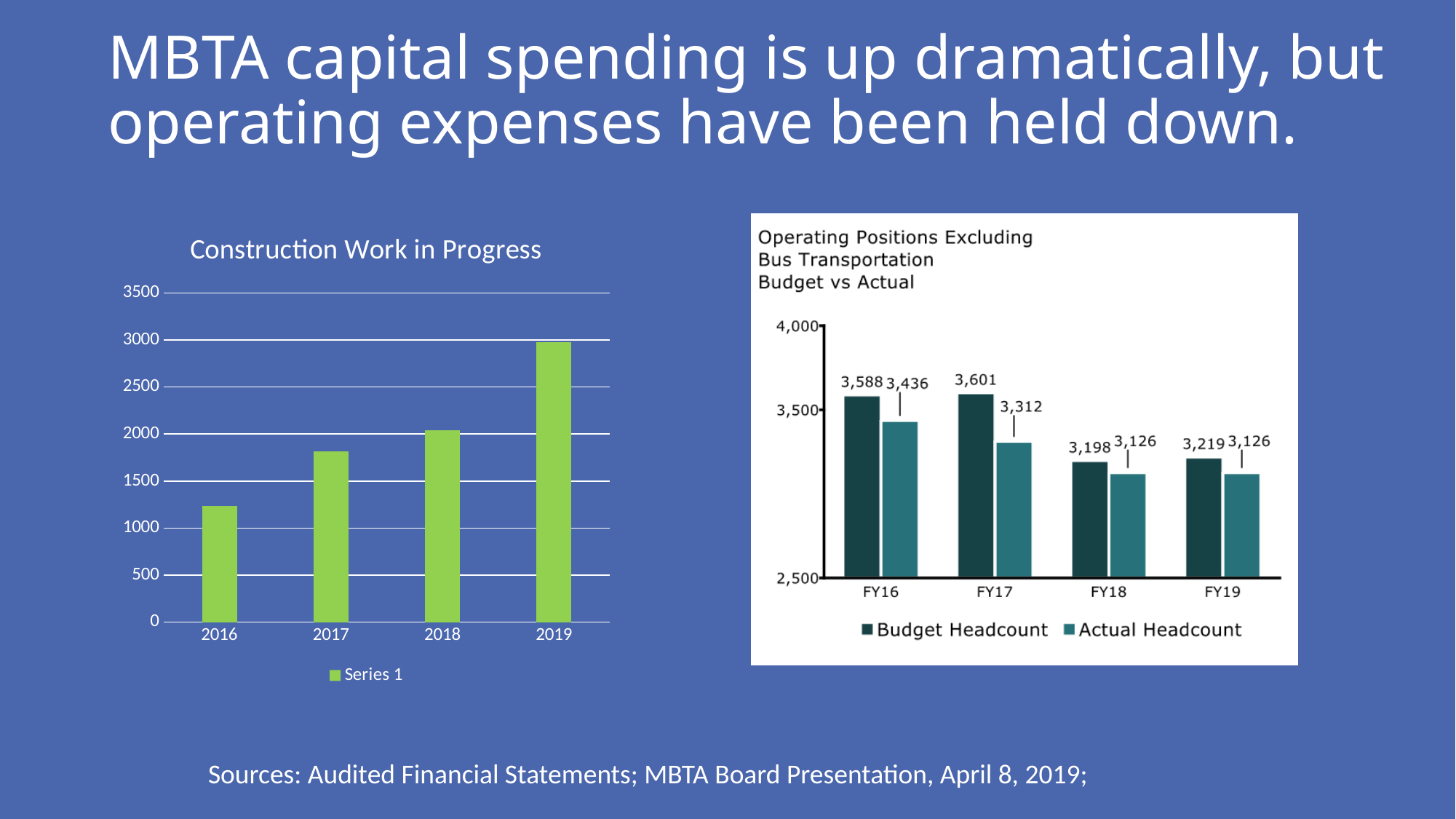
What type of chart is the 'Construction Work in Progress' chart? bar chart How many series does the legend of the 'Operating Positions Excluding Bus Transportation Budget vs Actual' chart list? 2 In the 'Construction Work in Progress' chart, which year has the highest value? 2019 In the 'Construction Work in Progress' chart, which year has the lowest value? 2016 In the 'Construction Work in Progress' chart, is the value for 2016 greater or less than 1500? less In the 'Operating Positions Excluding Bus Transportation Budget vs Actual' chart, what is the Budget Headcount for FY17? 3,601 In the 'Operating Positions Excluding Bus Transportation Budget vs Actual' chart, what is the Actual Headcount for FY19? 3,126 In the 'Construction Work in Progress' chart, is the value for 2017 greater or less than 1500? greater In the 'Construction Work in Progress' chart, how many years are shown on the x axis? 4 In the 'Construction Work in Progress' chart, do the values rise or fall from 2016 to 2019? rise In the 'Operating Positions Excluding Bus Transportation Budget vs Actual' chart, what is the difference between the Budget Headcount and Actual Headcount for FY17? 289 In the 'Operating Positions Excluding Bus Transportation Budget vs Actual' chart, which fiscal year has the lowest Budget Headcount? FY18